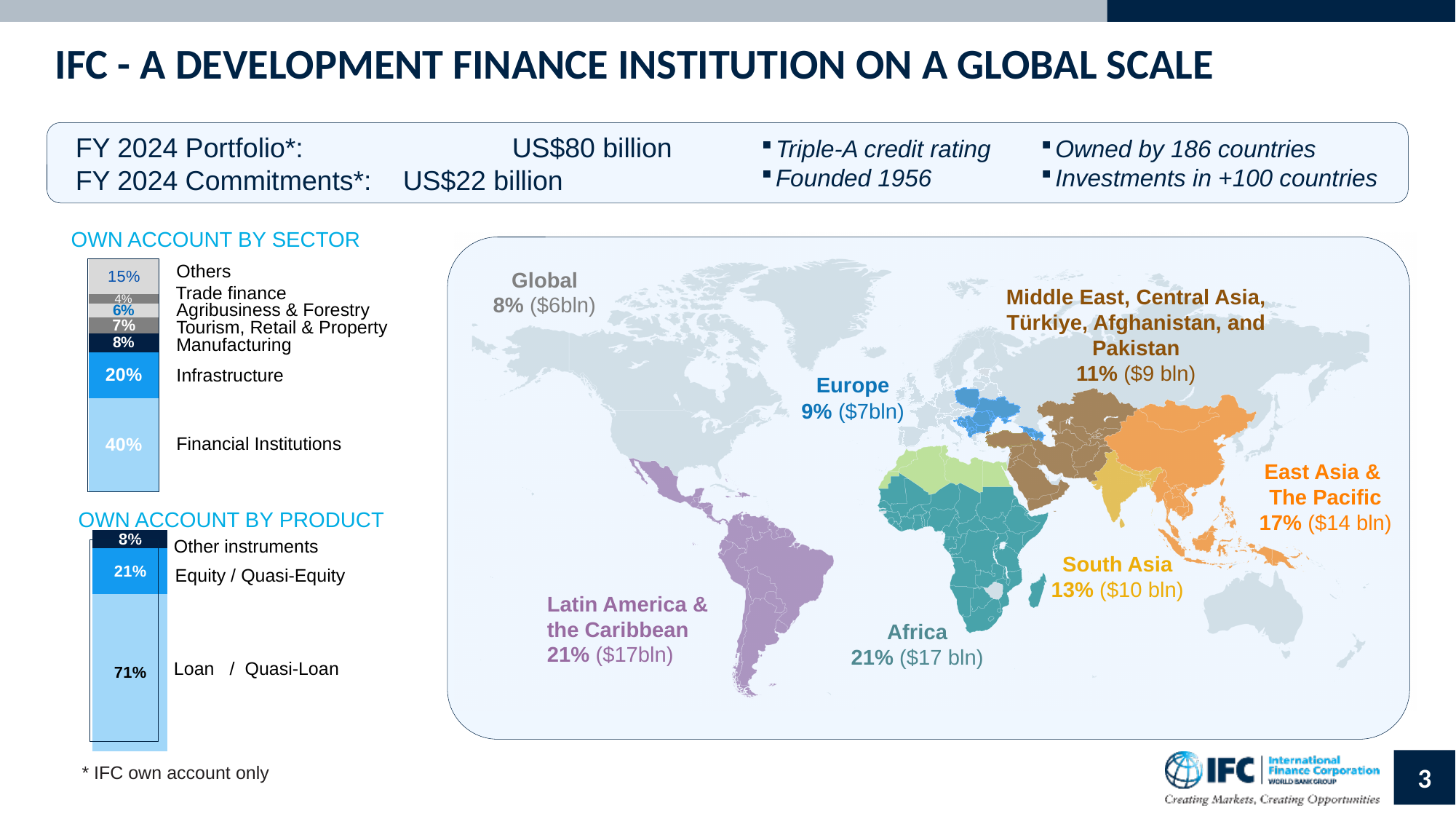
In the 'Own Account by Product' chart, what share is Loan / Quasi-Loan? 71% In the 'Own Account by Sector' chart, how many sector segments are shown? 7 In the 'Own Account by Sector' chart, what share is Infrastructure? 20% In the 'Own Account by Sector' chart, what is the difference between the Financial Institutions share and the Infrastructure share? 20% In the 'Own Account by Product' chart, which product has the smallest share? Other instruments In the 'Own Account by Product' chart, what share is Equity / Quasi-Equity? 21% In the 'Own Account by Sector' chart, which sector has the largest share? Financial Institutions What kind of chart is the 'Own Account by Product' chart? Stacked bar chart In the 'Own Account by Product' chart, which is larger: Equity / Quasi-Equity or Other instruments? Equity / Quasi-Equity In the 'Own Account by Sector' chart, what share is Financial Institutions? 40% On the world map, what share and amount are shown for East Asia & The Pacific? 17% ($14 bln) In the 'Own Account by Sector' chart, which sector has the smallest share? Trade finance